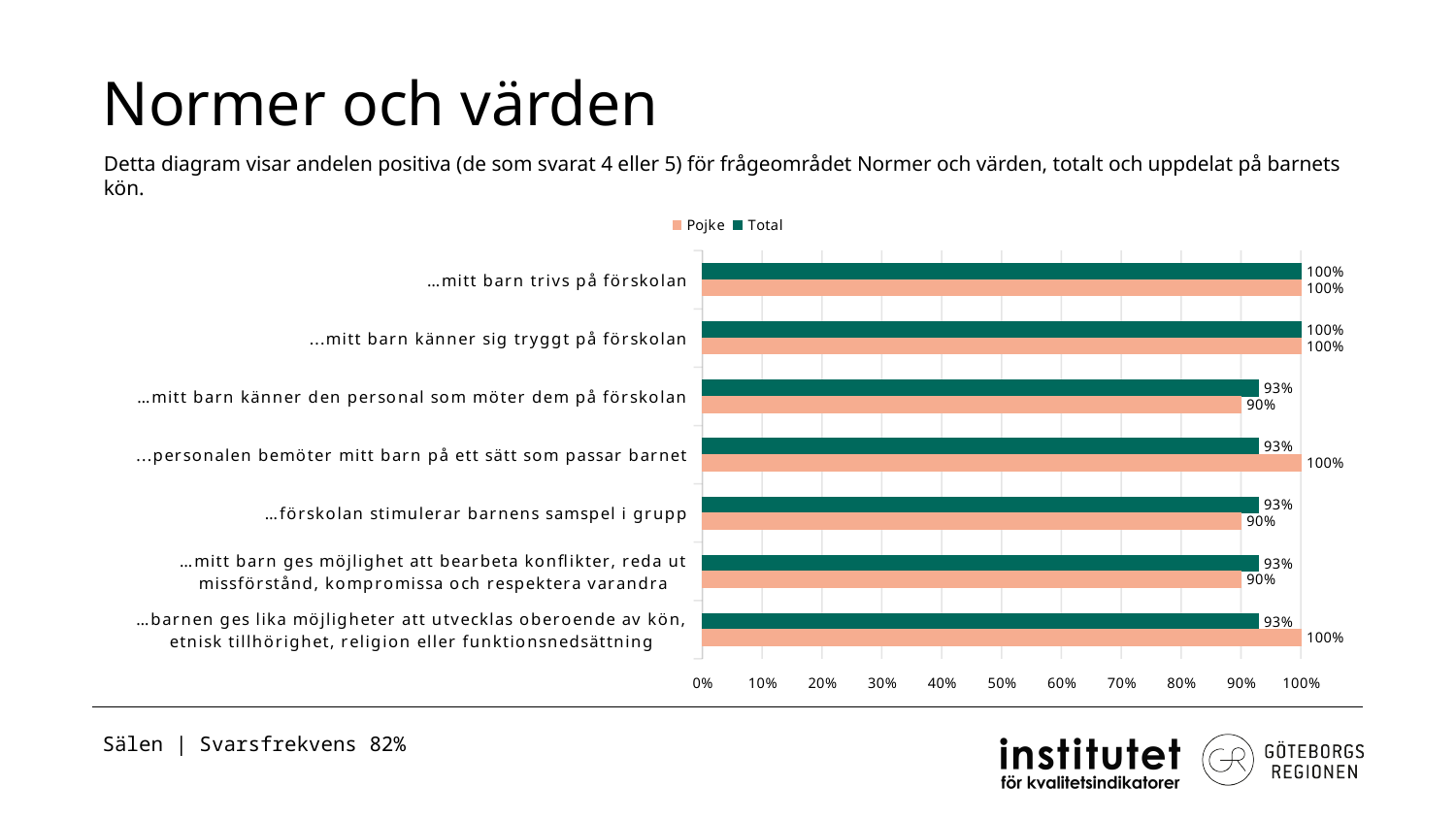
For '...personalen bemöter mitt barn på ett sätt som passar barnet', which is larger, the Pojke value or the Total value? Pojke Which series is shown in dark green in the chart? Total What is the Total value for '…förskolan stimulerar barnens samspel i grupp'? 93% What is the Pojke value for '…barnen ges lika möjligheter att utvecklas oberoende av kön, etnisk tillhörighet, religion eller funktionsnedsättning'? 100% What is the difference between the Total and Pojke values for '…mitt barn ges möjlighet att bearbeta konflikter, reda ut missförstånd, kompromissa och respektera varandra'? 3% How many series does the legend list? 2 What kind of chart is shown on the slide? bar chart What is the Pojke value for '...personalen bemöter mitt barn på ett sätt som passar barnet'? 100% What is the Total value for '…mitt barn trivs på förskolan'? 100% How many categories (statements) are plotted in the chart? 7 What is the Total value for '…mitt barn känner den personal som möter dem på förskolan'? 93% What is the Pojke value for '…mitt barn känner den personal som möter dem på förskolan'? 90%